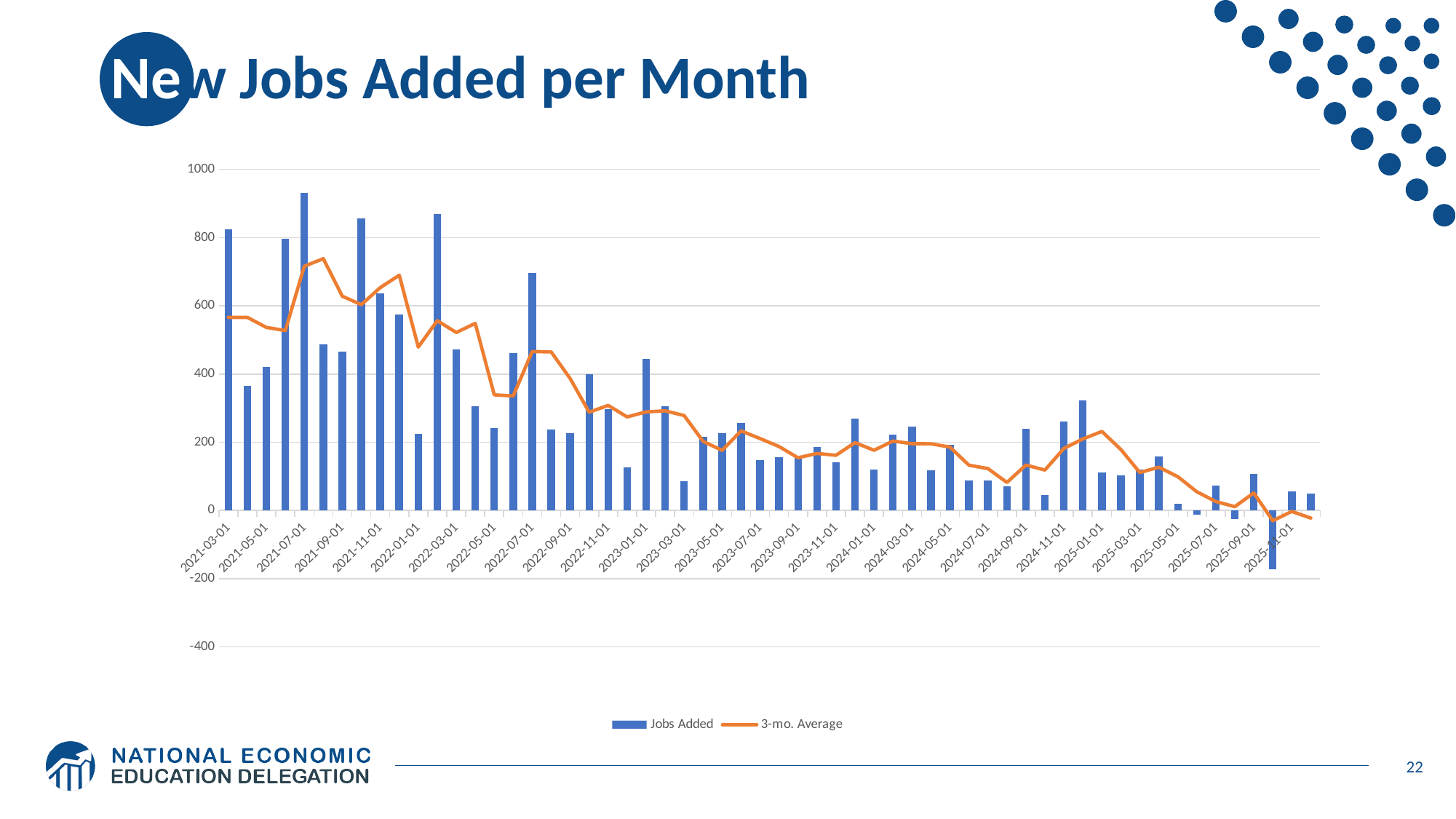
Overall, do the Jobs Added values rise or fall from 2021 to 2025? fall What are the two series named in the legend? Jobs Added and 3-mo. Average Which series is drawn as an orange line? 3-mo. Average Is the Jobs Added value for 2023-03-01 greater or less than 200? less Is the Jobs Added value for 2022-07-01 greater or less than 600? greater Which month has a larger Jobs Added value, 2021-03-01 or 2021-05-01? 2021-03-01 Which month has the lowest Jobs Added bar? 2025-10-01 What kind of chart is shown on the slide? A bar chart with a line overlay Is the Jobs Added value for 2025-01-01 greater or less than 200? less Which month has the highest Jobs Added bar? 2021-07-01 How many series does the legend list? 2